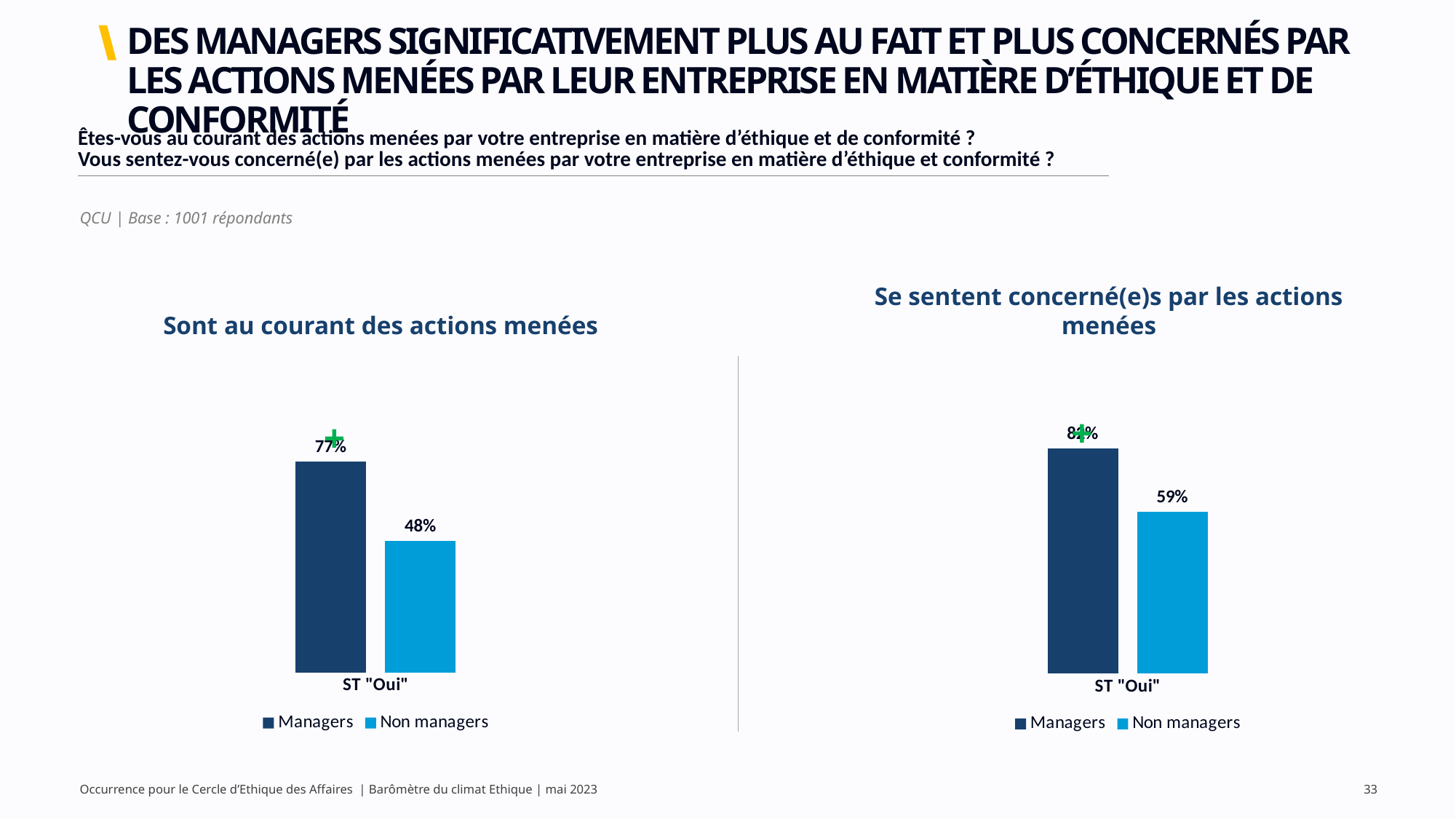
Which chart has the higher Non managers value, "Sont au courant des actions menées" or "Se sentent concerné(e)s par les actions menées"? Se sentent concerné(e)s par les actions menées In the chart titled "Se sentent concerné(e)s par les actions menées", what is the value for Non managers? 59% What is the category label on the x axis of the right chart? ST "Oui" In the chart titled "Sont au courant des actions menées", which series has the higher value, Managers or Non managers? Managers What kind of chart is the chart titled "Sont au courant des actions menées"? Bar chart In the chart titled "Se sentent concerné(e)s par les actions menées", which series has the higher value, Managers or Non managers? Managers How many series does the legend of the left chart list? 2 In the chart titled "Sont au courant des actions menées", what is the difference between the Managers and Non managers values? 29 percentage points In the chart titled "Se sentent concerné(e)s par les actions menées", is the value for Managers greater or less than 70%? greater In the chart titled "Sont au courant des actions menées", what is the value for Non managers? 48% In the left chart, which series is shown in dark blue? Managers In the chart titled "Sont au courant des actions menées", what is the value for Managers? 77%